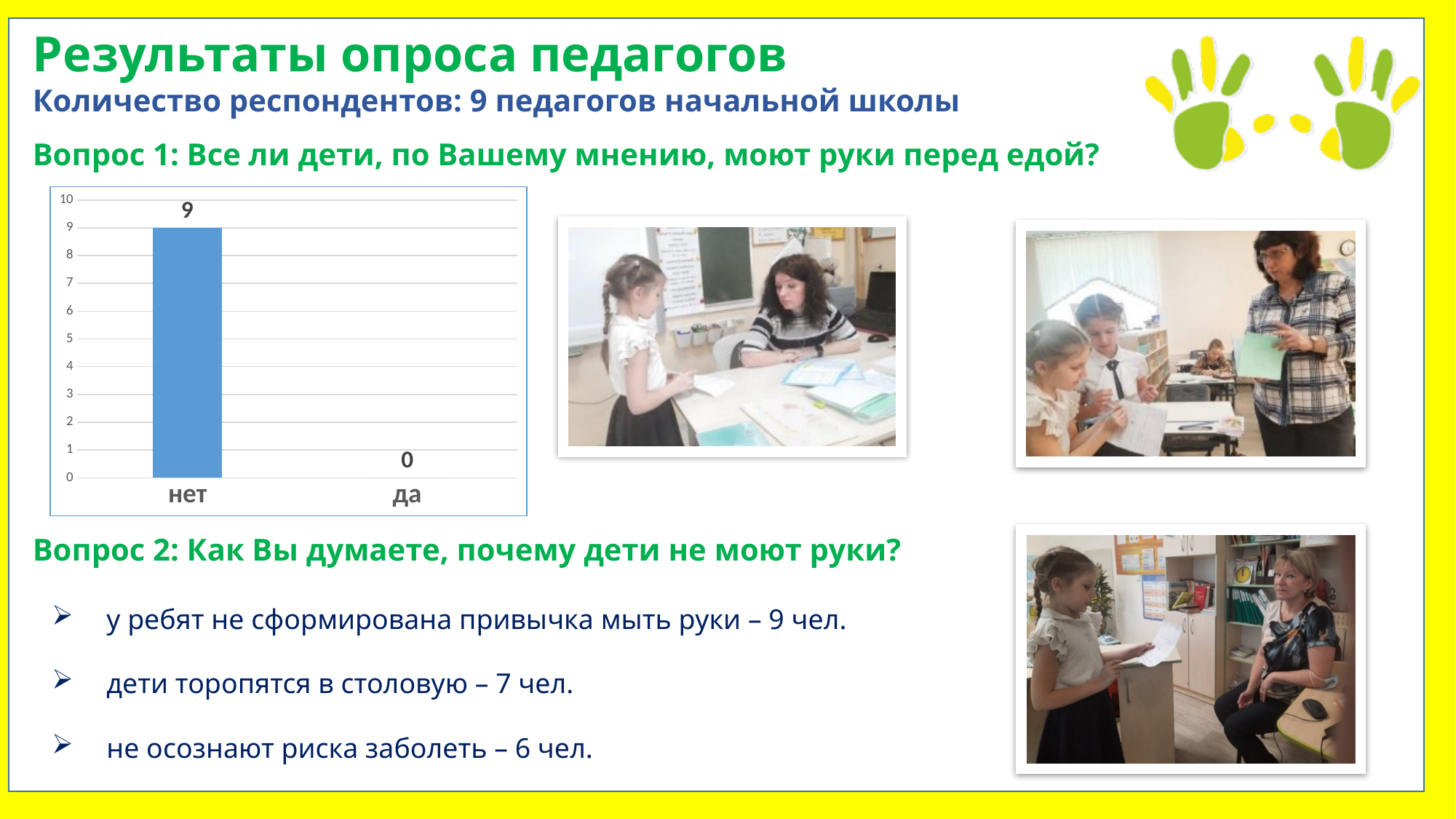
What colour are the bars in the chart? blue Which category has the lowest value in the chart? да What is the value for "нет" in the chart? 9 Is the value for "нет" greater or less than 5? greater What is the difference between the values for "нет" and "да"? 9 What kind of chart is shown on the slide? bar chart How many categories are shown on the x axis of the chart? 2 What is the value for "да" in the chart? 0 Which category has the highest value in the chart? нет Which is larger, the value for "нет" or the value for "да"? нет What is the maximum value shown on the chart's vertical axis? 10